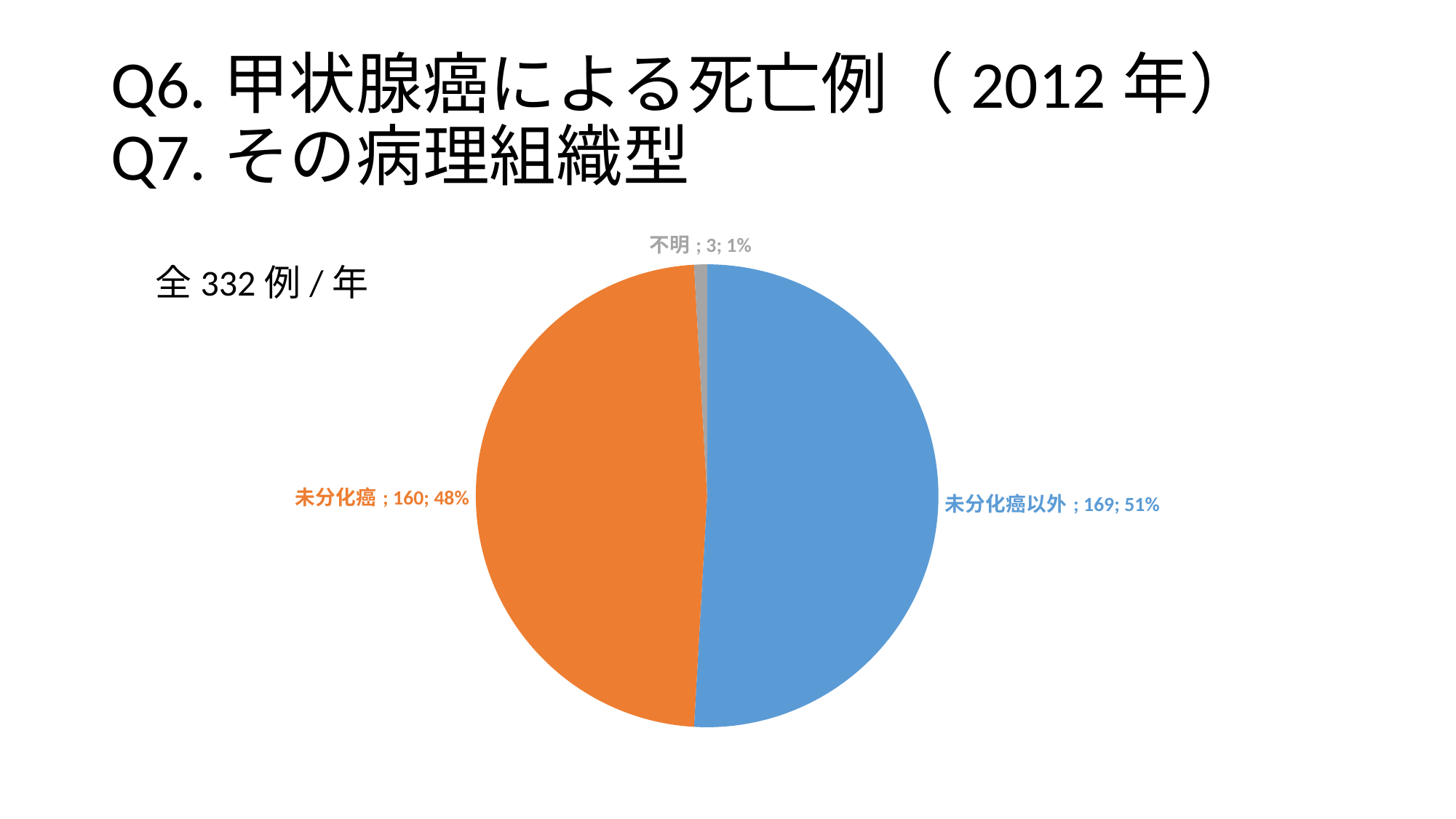
What total number of cases per year is stated next to the pie chart? 全 332 例 / 年 What is the difference between the values for 未分化癌 and 不明? 157 What is the difference between the values for 未分化癌以外 and 未分化癌? 9 What kind of chart is shown on the slide? pie chart What share of the pie does 不明 represent? 1% How many slices does the pie chart have? 3 What is the value for 不明? 3 What share of the pie does 未分化癌 represent? 48% What is the value for 未分化癌以外? 169 What is the value for 未分化癌? 160 What share of the pie does 未分化癌以外 represent? 51% Which category has the smallest slice? 不明